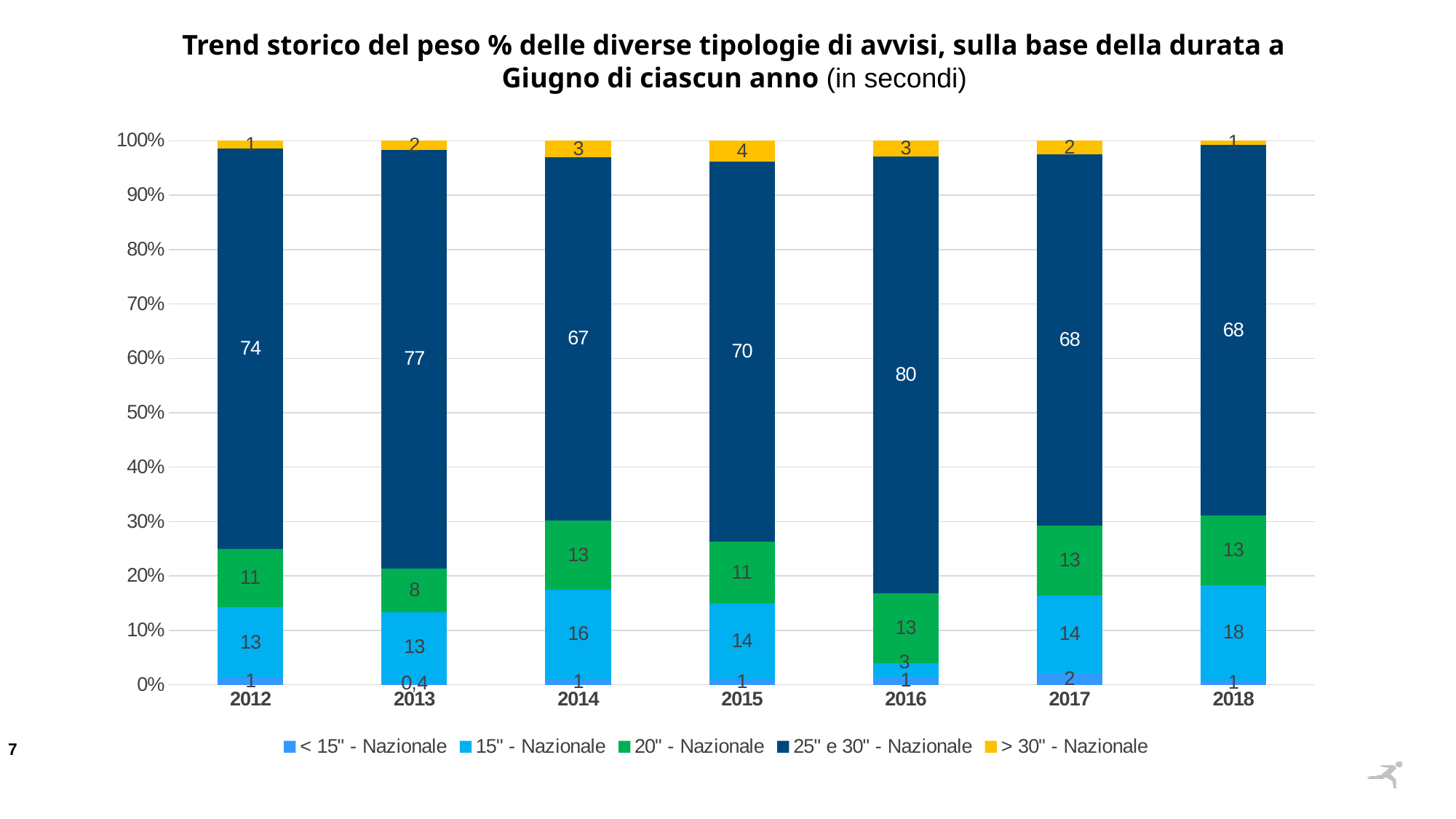
What is the value for the 15'' - Nazionale series in 2018? 18 What kind of chart is shown on the slide? Stacked bar chart Which is larger, the 15'' - Nazionale value in 2014 or in 2016? 2014 In which year is the 25'' e 30'' - Nazionale series highest? 2016 What is the value for the 25'' e 30'' - Nazionale series in 2016? 80 How many series does the legend list? 5 In which year is the 25'' e 30'' - Nazionale series lowest? 2014 How many years are shown on the x axis? 7 What is the difference between the 25'' e 30'' - Nazionale values in 2016 and 2014? 13 What is the value for the < 15'' - Nazionale series in 2013? 0,4 Which series is shown in yellow in the legend? > 30'' - Nazionale From 2012 to 2015, does the > 30'' - Nazionale series rise or fall? Rise